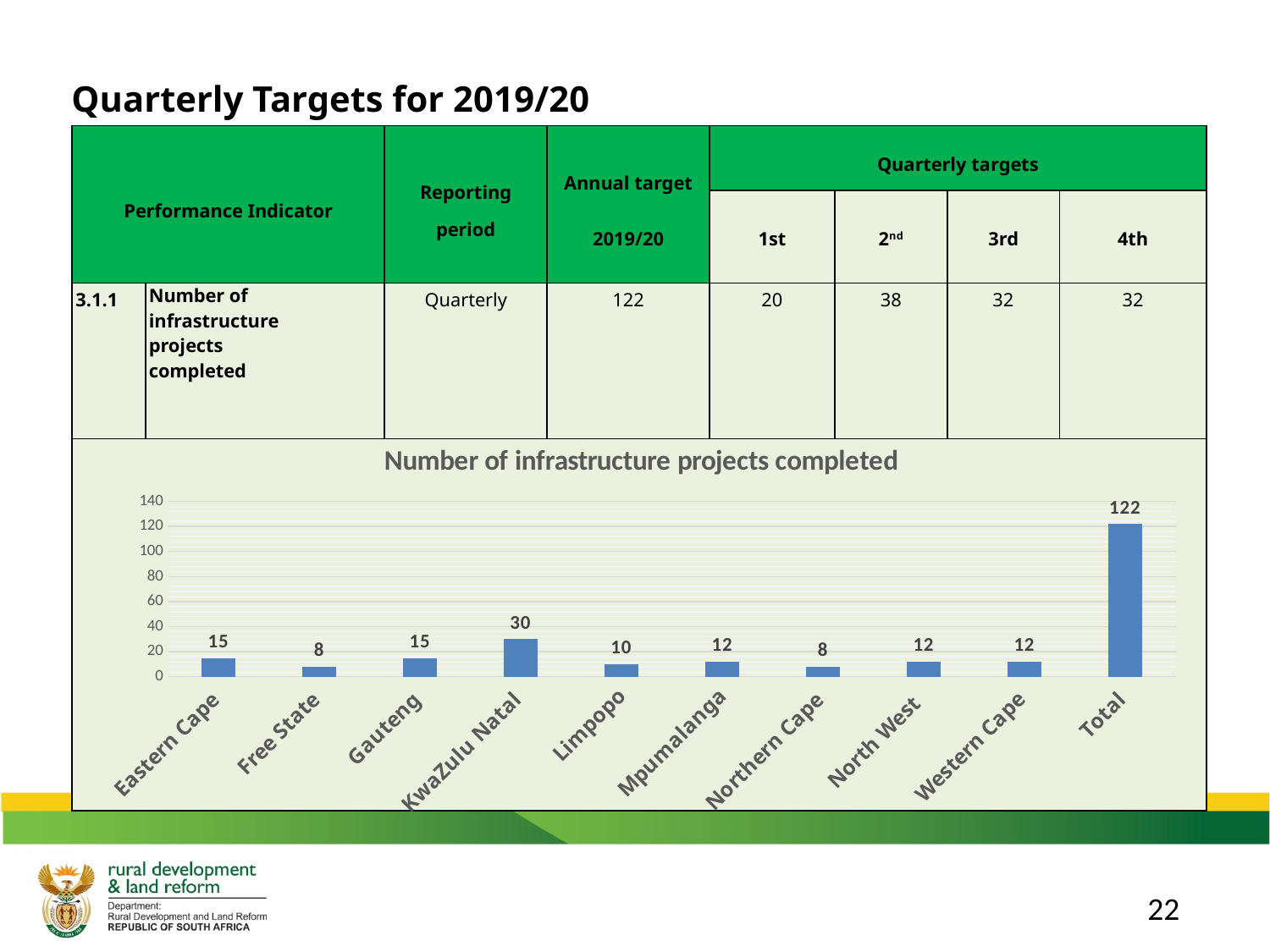
Which is larger, the value for Eastern Cape or the value for Limpopo? Eastern Cape What is the value for Free State in the chart? 8 Is the value for the Total bar greater or less than 100? greater What is the value for Limpopo in the chart? 10 What is the title of the chart? Number of infrastructure projects completed How many bars are plotted in the chart? 10 What type of chart is shown on the slide? bar chart Excluding the Total bar, which province has the highest number of infrastructure projects completed? KwaZulu Natal What is the value for KwaZulu Natal in the chart? 30 What is the difference between the values for KwaZulu Natal and Gauteng? 15 What is the difference between the values for Eastern Cape and Northern Cape? 7 What is the value for the Total bar in the chart? 122